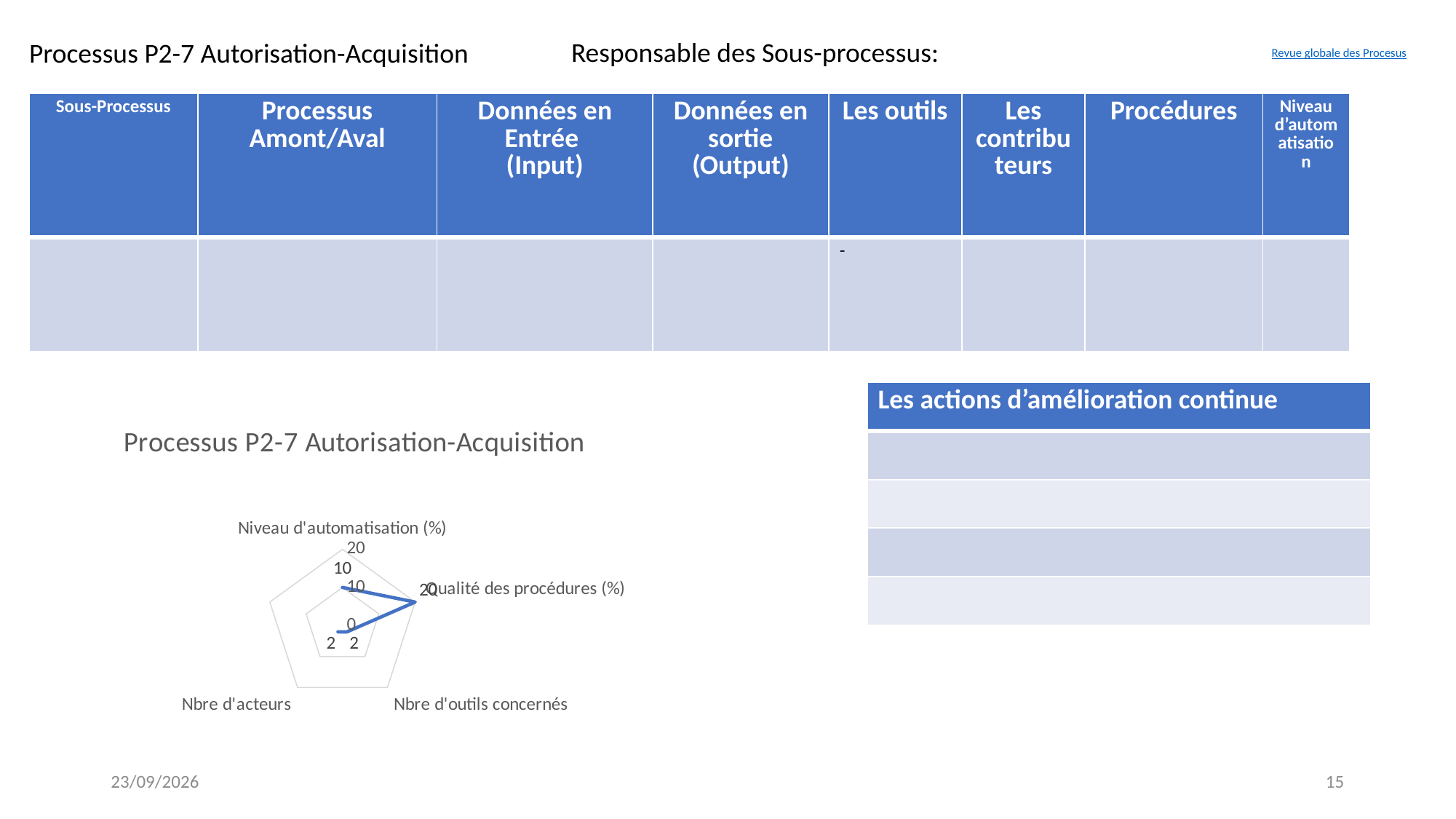
What is the value for Niveau d'automatisation (%) in the radar chart? 10 Which is larger in the radar chart: Qualité des procédures (%) or Niveau d'automatisation (%)? Qualité des procédures (%) What kind of chart is shown on the slide? Radar chart What is the title of the chart on the slide? Processus P2-7 Autorisation-Acquisition What is the highest tick value shown on the radar chart's axis? 20 How many axes (categories) does the radar chart have? 5 Which category has the highest value in the radar chart? Qualité des procédures (%) What is the value for Qualité des procédures (%) in the radar chart? 20 What is the difference between the values for Qualité des procédures (%) and Niveau d'automatisation (%)? 10